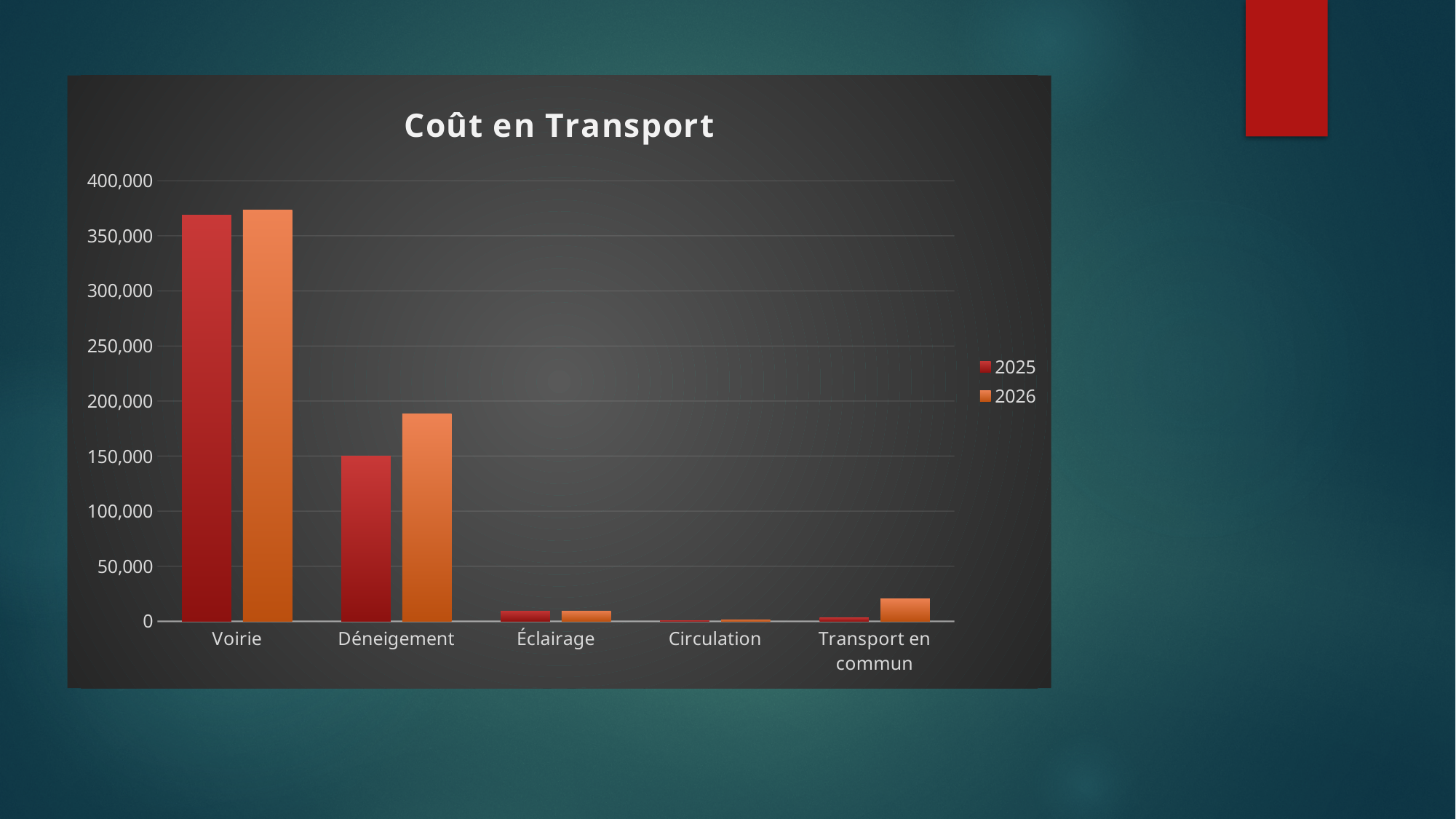
Is the value for Déneigement in 2026 greater or less than 200,000? less Which category has the lowest value for 2025? Circulation Which category has the highest value for 2026? Voirie Which is larger for Déneigement, the 2025 value or the 2026 value? 2026 How many series does the legend list? 2 What is the title of the chart? Coût en Transport How many categories are shown on the x axis? 5 Is the value for Voirie in 2025 greater or less than 350,000? greater Which is larger for Transport en commun, the 2025 value or the 2026 value? 2026 What kind of chart is shown on the slide? bar chart Is the value for Éclairage in 2026 greater or less than 50,000? less Which legend entry is shown in orange? 2026